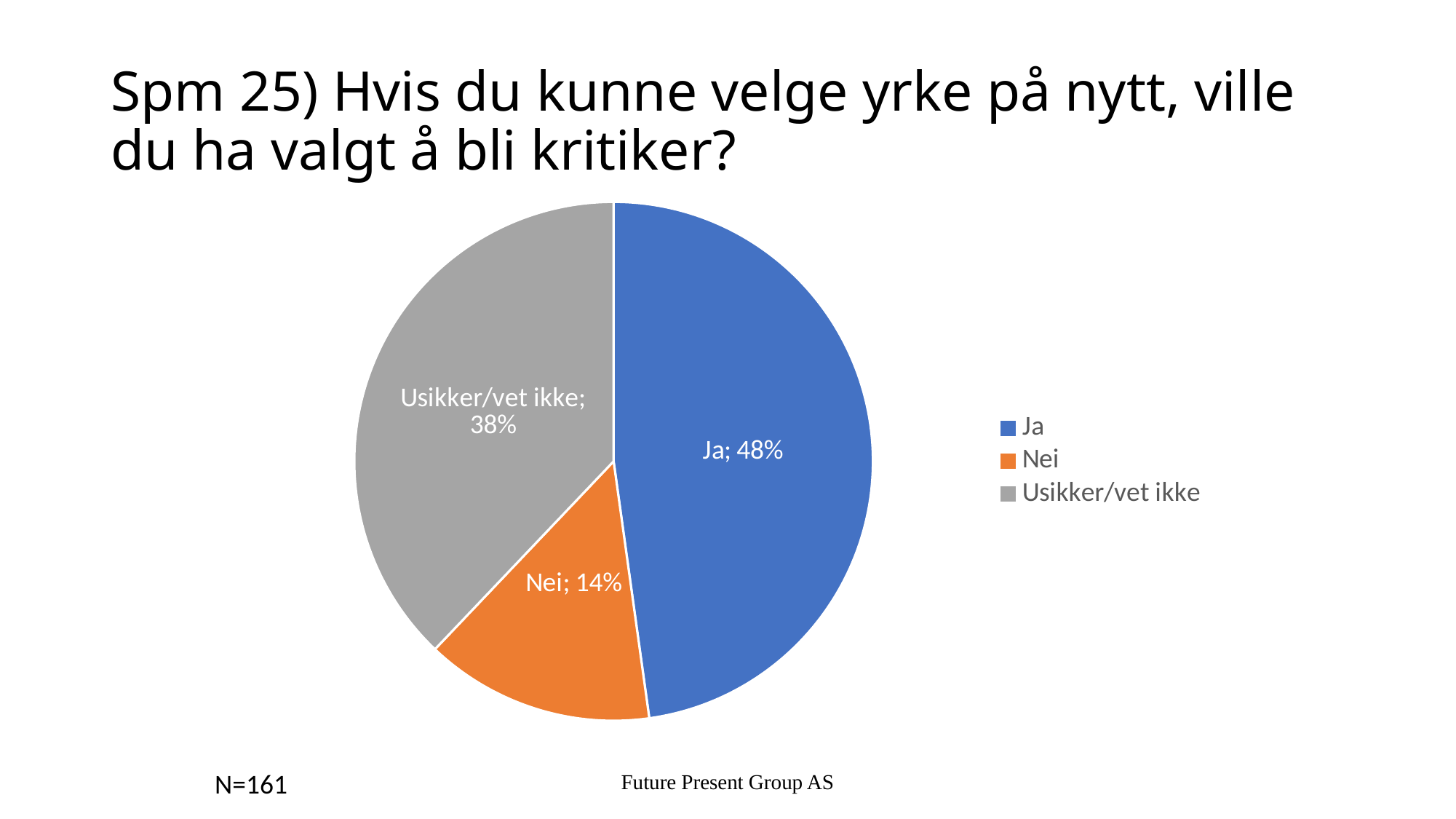
What kind of chart is shown on the slide? pie chart Which answer category has the smallest slice of the pie? Nei What is the difference in percentage points between "Ja" and "Nei"? 34 What share of respondents answered "Nei"? 14% What is the difference in percentage points between "Ja" and "Usikker/vet ikke"? 10 How many slices does the pie chart have? 3 What colour is the "Nei" slice in the pie chart? orange What share of respondents answered "Ja"? 48% How many entries does the legend list? 3 What share of respondents answered "Usikker/vet ikke"? 38% Which answer category has the largest slice of the pie? Ja Which is larger, the share for "Usikker/vet ikke" or the share for "Nei"? Usikker/vet ikke